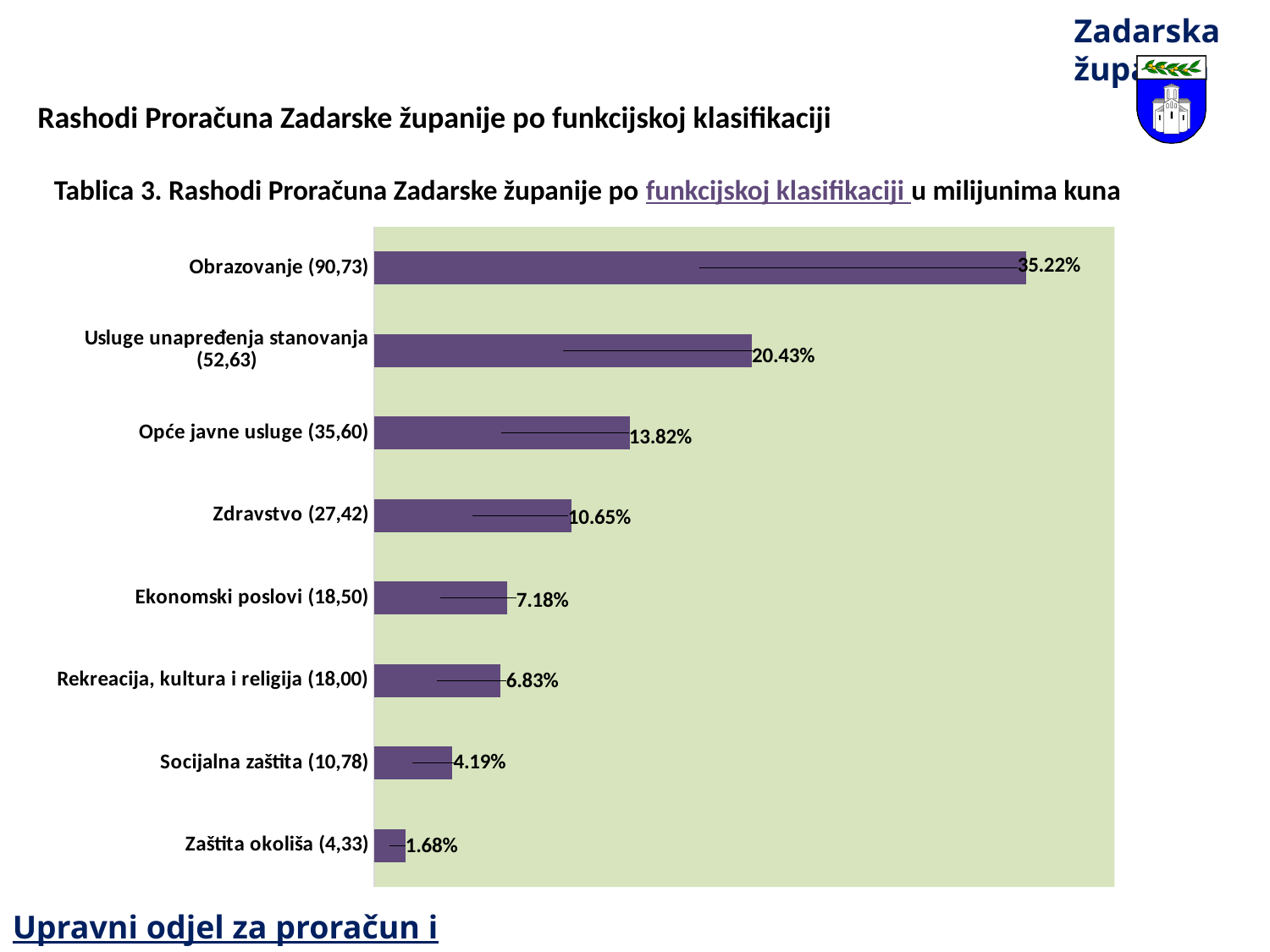
Which category has the lowest percentage? Zaštita okoliša (4,33) What kind of chart is shown on the slide? Bar chart What is the difference in percentage points between Opće javne usluge (35,60) and Zdravstvo (27,42)? 3.17% How many categories are shown in the chart? 8 Which has a larger percentage, Ekonomski poslovi (18,50) or Socijalna zaštita (10,78)? Ekonomski poslovi (18,50) What percentage is shown for Socijalna zaštita (10,78)? 4.19% What percentage is shown for Obrazovanje (90,73)? 35.22% Do the percentages decrease or increase going from the top bar to the bottom bar? Decrease What percentage is shown for Rekreacija, kultura i religija (18,00)? 6.83% What is the difference in percentage points between Obrazovanje (90,73) and Usluge unapređenja stanovanja (52,63)? 14.79% What percentage is shown for Zdravstvo (27,42)? 10.65% Which category has the highest percentage? Obrazovanje (90,73)